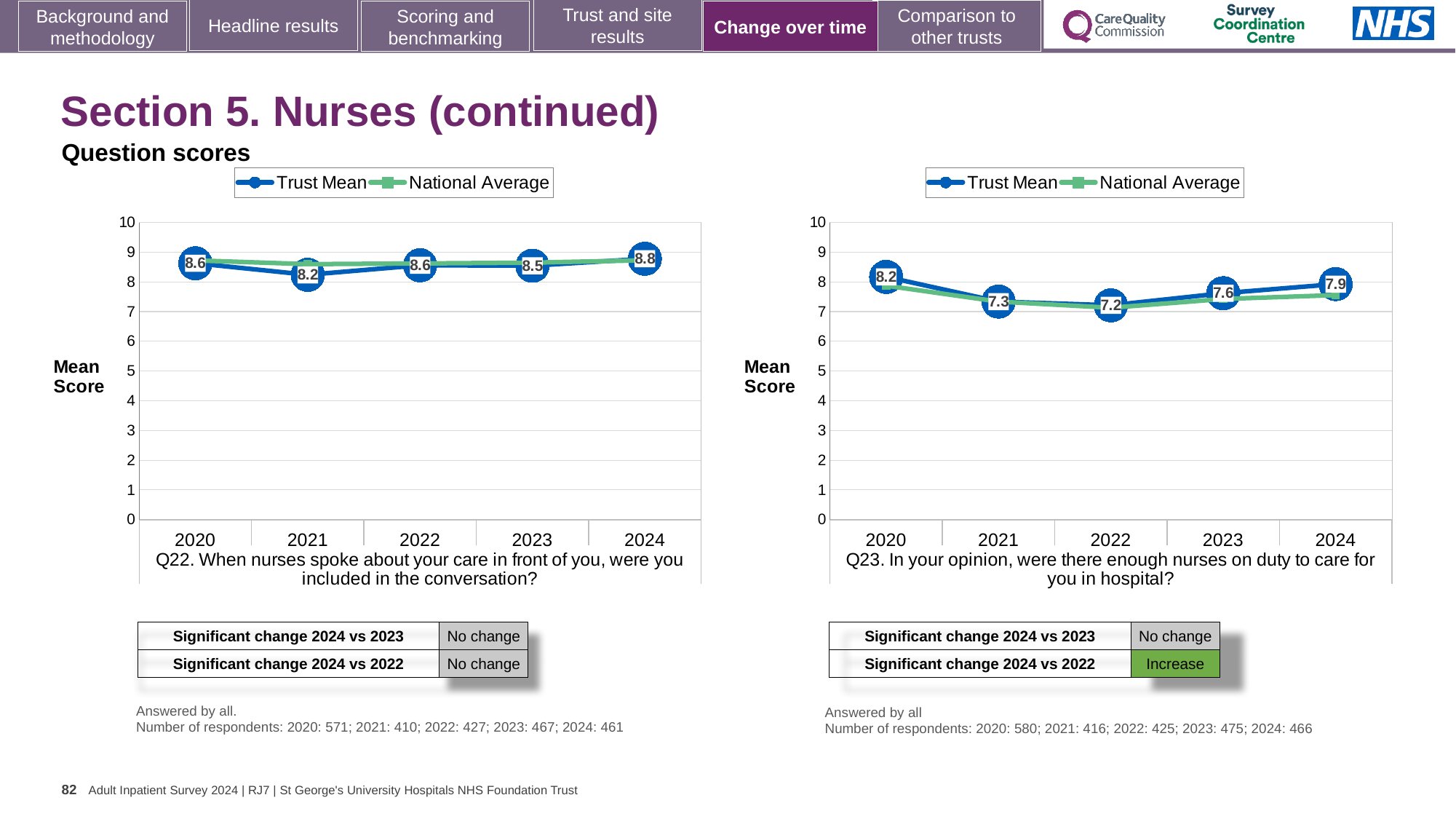
On the Q23 chart (right), which year has the lowest Trust Mean score? 2022 On the Q22 chart (left), what is the difference between the Trust Mean scores for 2024 and 2021? 0.6 On the Q23 chart (right), what is the Trust Mean score for 2020? 8.2 On the Q23 chart (right), what is the difference between the Trust Mean scores for 2020 and 2022? 1.0 On the Q23 chart (right), is the National Average value for 2022 greater or less than 8? less How many series does the legend of the Q23 chart (right) list? 2 On the Q22 chart (left), which year has the highest Trust Mean score? 2024 What type of chart is used for Q22 (left)? Line chart On the Q23 chart (right), is the Trust Mean score higher in 2023 or 2024? 2024 On the Q22 chart (left), what is the Trust Mean score for 2024? 8.8 How many years are shown on the x axis of the Q22 chart (left)? 5 On the Q22 chart (left), what is the Trust Mean score for 2021? 8.2